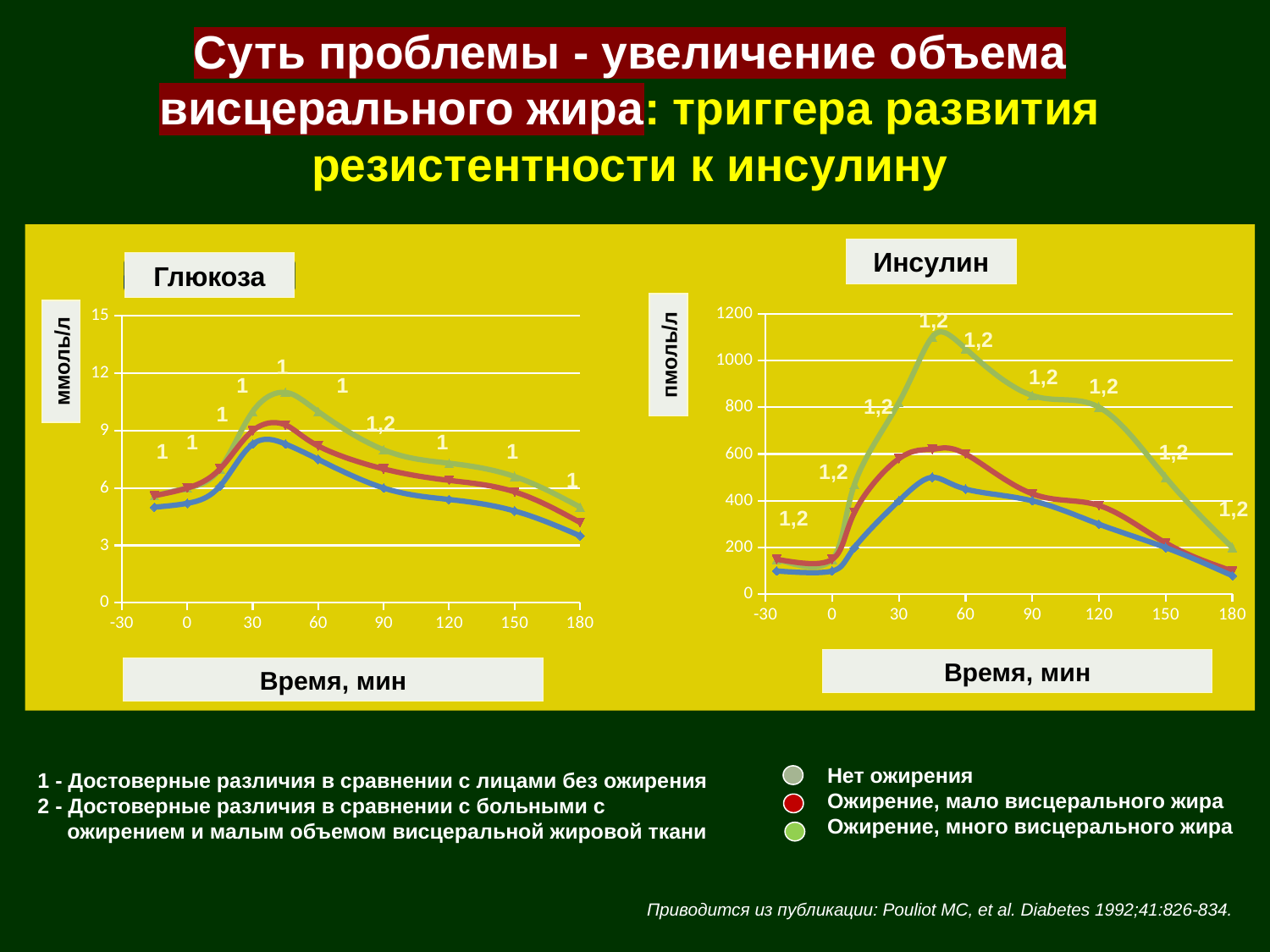
On the Инсулин chart, which line reaches the highest peak? the light green line On the Глюкоза chart, is the peak value of the light green line greater or less than 9? greater What kind of chart is the Глюкоза chart? line chart How many lines are plotted on the Инсулин chart? 3 On the Инсулин chart, is the peak value of the blue line greater or less than 600? less How many entries does the legend at the bottom of the slide list? 3 On the Инсулин chart, is the value of the light green line at 180 min greater or less than 400? less How many tick labels are shown on the x axis of the Глюкоза chart? 8 What is the y-axis label of the Инсулин chart? пмоль/л On the Инсулин chart, do the values of the light green line rise or fall between 60 and 180 min? fall On the Глюкоза chart, which line has the lowest values at 180 min? the blue line